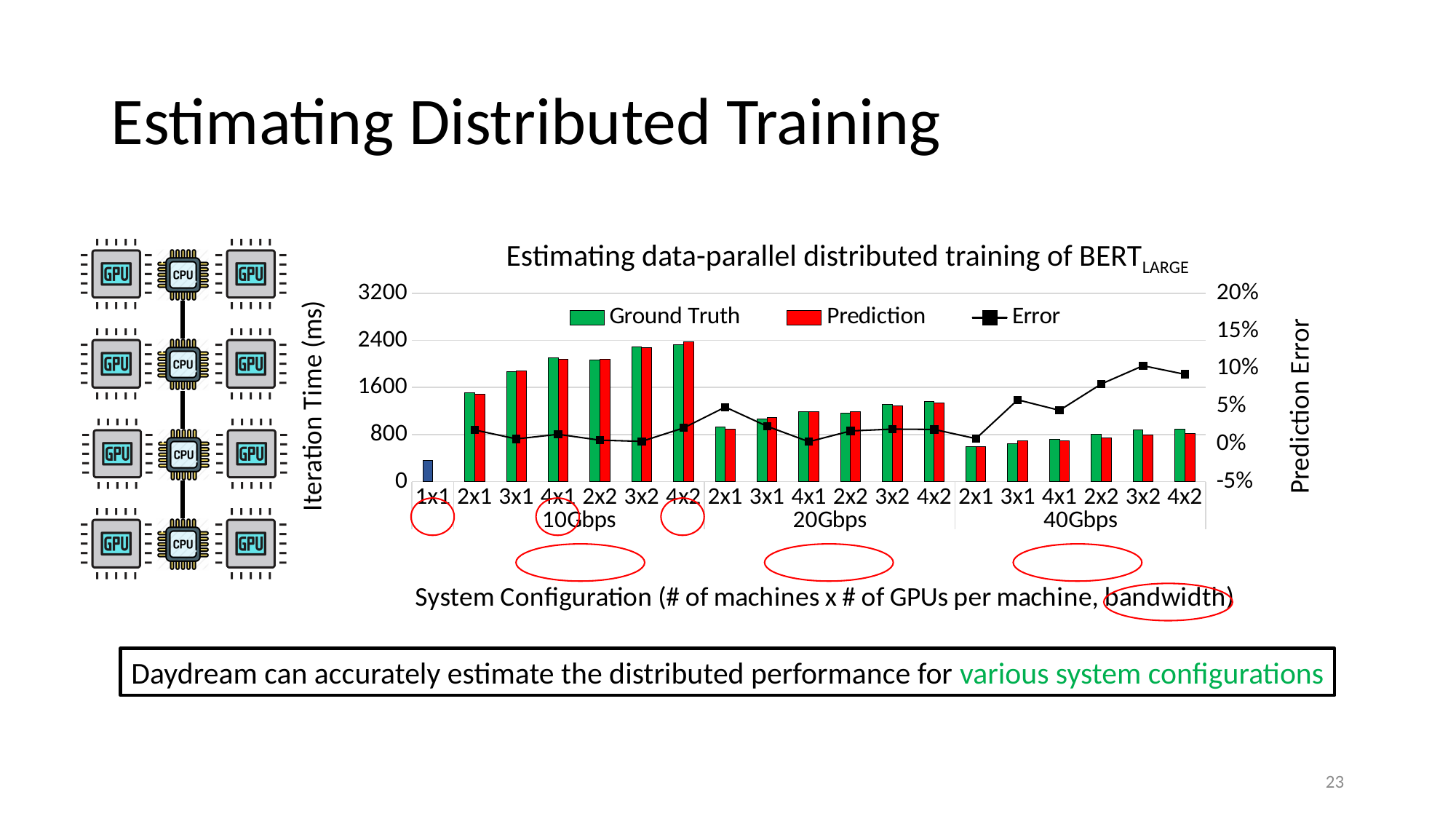
Which configuration has the highest Prediction iteration time? 4x2 at 10Gbps How many series does the chart legend list? 3 Which configuration has the lowest Ground Truth iteration time among the 40Gbps group? 2x1 Is the Error for 2x1 at 10Gbps greater or less than 5%? less What kind of chart is shown on the slide? Bar chart with a line series Which has the larger Ground Truth iteration time: 4x1 at 10Gbps or 4x1 at 20Gbps? 4x1 at 10Gbps What is the title of the chart? Estimating data-parallel distributed training of BERT LARGE Is the Ground Truth iteration time for 2x1 at 40Gbps greater or less than 800 ms? less How many system configurations are shown along the x axis of the chart? 19 Which series are listed in the chart legend? Ground Truth, Prediction, Error Is the Ground Truth iteration time for 4x2 at 10Gbps greater or less than 1600 ms? greater